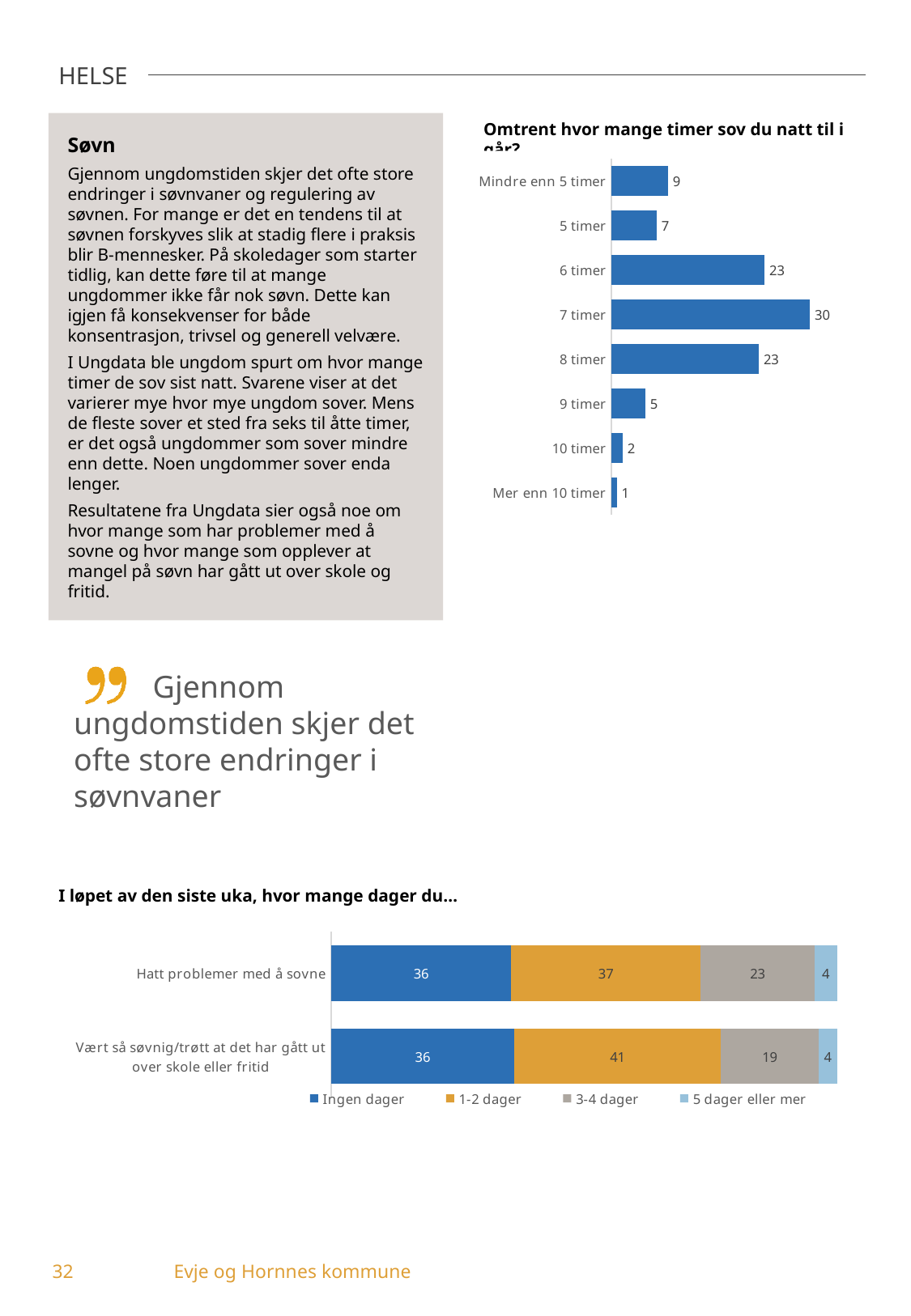
In the bottom chart ("I løpet av den siste uka, hvor mange dager du..."), what is the total of the bar "Hatt problemer med å sovne"? 100 What kind of chart is the top chart ("Omtrent hvor mange timer sov du natt til i går?")? Bar chart In the bottom chart ("I løpet av den siste uka, hvor mange dager du..."), what is the value for "1-2 dager" in the bar "Vært så søvnig/trøtt at det har gått ut over skole eller fritid"? 41 In the top chart ("Omtrent hvor mange timer sov du natt til i går?"), what is the difference between the values for "7 timer" and "6 timer"? 7 In the top chart ("Omtrent hvor mange timer sov du natt til i går?"), which category has the highest value? 7 timer In the top chart ("Omtrent hvor mange timer sov du natt til i går?"), how many categories are shown? 8 In the bottom chart ("I løpet av den siste uka, hvor mange dager du..."), what is the value for "3-4 dager" in the bar "Hatt problemer med å sovne"? 23 In the top chart ("Omtrent hvor mange timer sov du natt til i går?"), what is the value for "7 timer"? 30 In the top chart ("Omtrent hvor mange timer sov du natt til i går?"), which category has the lowest value? Mer enn 10 timer In the top chart ("Omtrent hvor mange timer sov du natt til i går?"), which is larger: the value for "5 timer" or "9 timer"? 5 timer In the top chart ("Omtrent hvor mange timer sov du natt til i går?"), what is the value for "Mindre enn 5 timer"? 9 In the bottom chart ("I løpet av den siste uka, hvor mange dager du..."), how many series does the legend list? 4